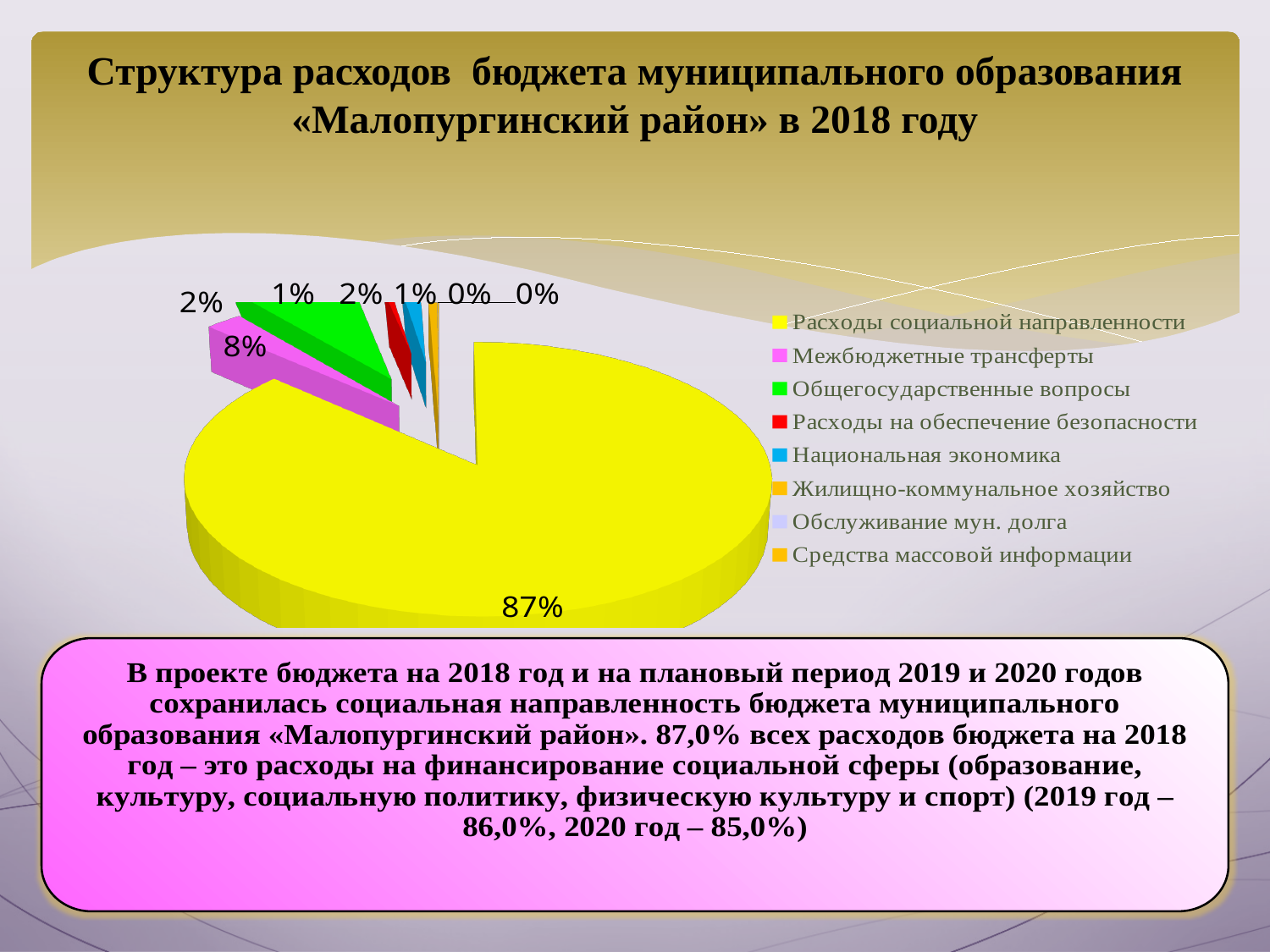
Which is larger: the share for Расходы социальной направленности or the share for Межбюджетные трансферты? Расходы социальной направленности What kind of chart is shown on the slide? pie chart How many categories does the legend of the pie chart list? 8 What share of the pie does Расходы социальной направленности have? 87% What is the title of the slide containing the pie chart? Структура расходов бюджета муниципального образования «Малопургинский район» в 2018 году By how many percentage points does the share for Расходы социальной направленности exceed the share for Межбюджетные трансферты? 85 Which category has the largest share of the pie chart? Расходы социальной направленности What share of the pie does Межбюджетные трансферты have? 2% What colour is the slice for Расходы социальной направленности? yellow